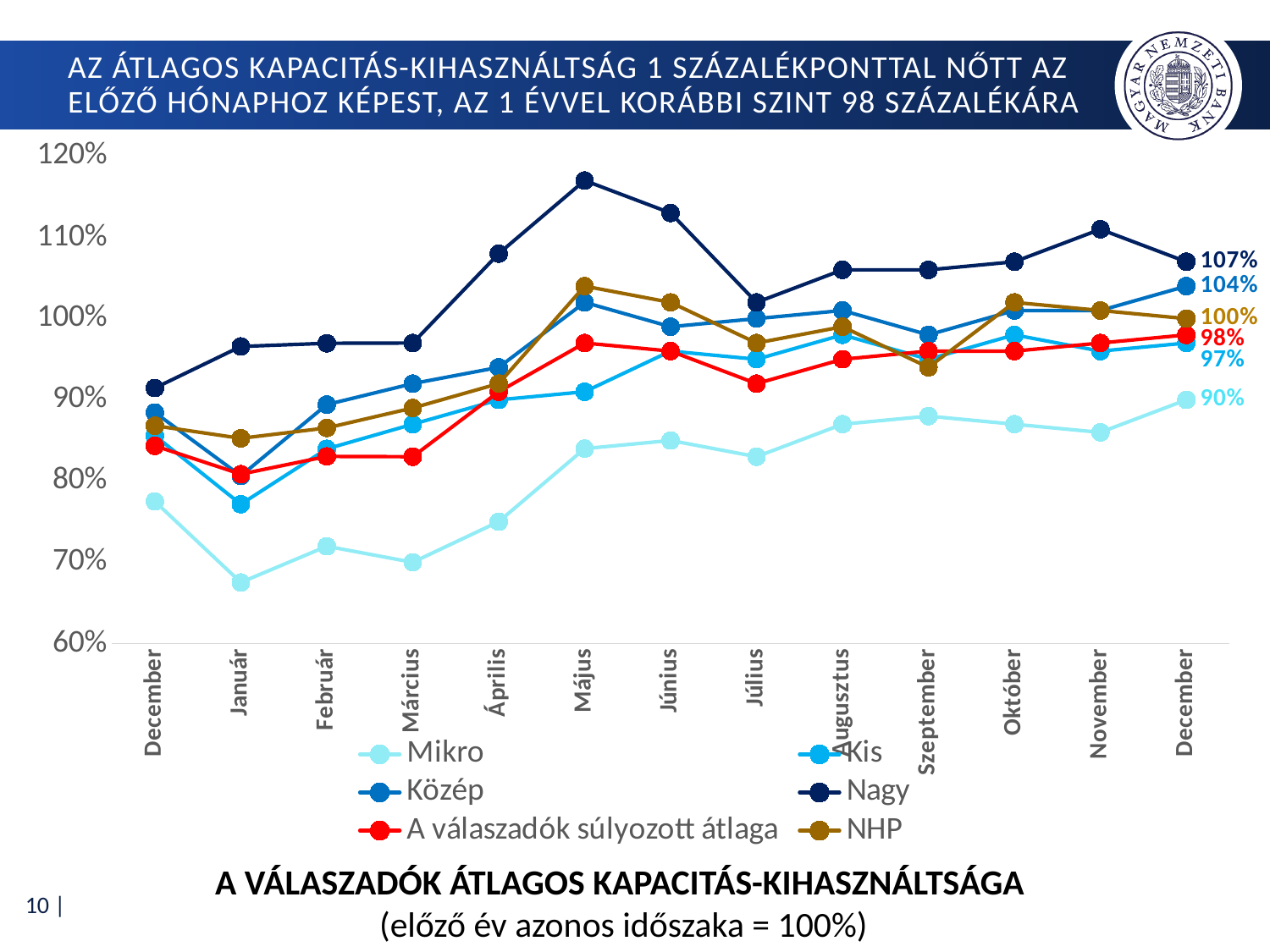
What is the value for Közép at the final December point? 104% What is the value for Nagy at the final December point? 107% Is the value for Nagy in Május greater or less than 110%? greater What is the value for Mikro at the final December point? 90% How many series does the legend list? 6 What is the value for A válaszadók súlyozott átlaga at the final December point? 98% What is the difference between the Nagy and Mikro values at the final December point? 17 percentage points Which series has the lowest value at the final December point? Mikro What kind of chart is shown on the slide? line chart At the final December point, which is larger: Közép or Kis? Közép Is the value for Mikro in Január greater or less than 70%? less Which series has the highest value at the final December point? Nagy